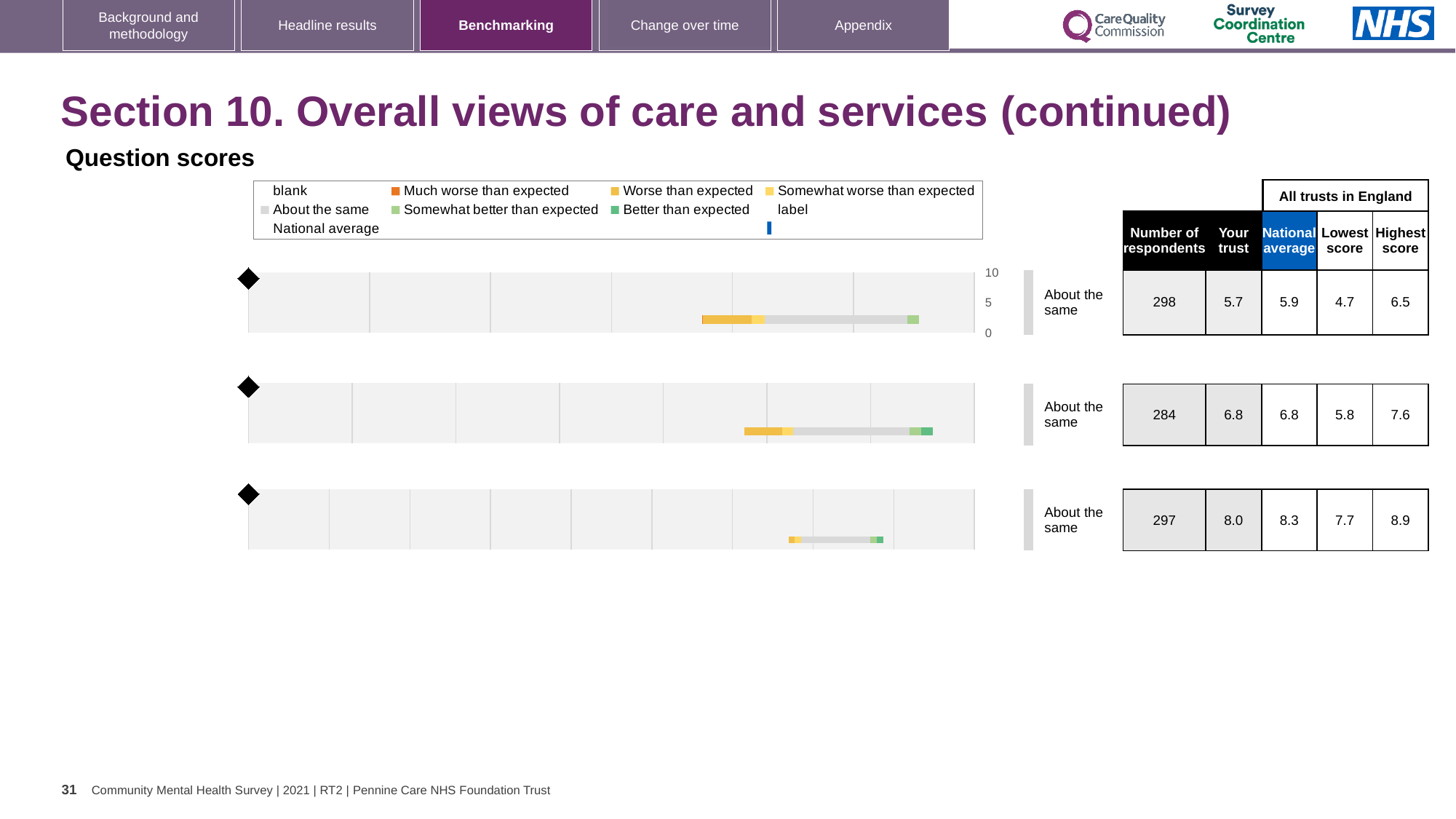
What is the national average for the middle chart? 6.8 For the middle chart, what is the difference between the highest score and the lowest score among all trusts in England? 1.8 For the bottom chart, what is the difference between the national average and the 'Your trust' score? 0.3 Which chart has the highest 'Your trust' score? The bottom chart (8.0) Which chart has the fewest respondents? The middle chart (284) What is the highest score among all trusts in England for the bottom chart? 8.9 What is the 'Your trust' score for the top chart? 5.7 How many respondents are shown for the top chart? 298 What benchmark category is shown for the top chart? About the same How many question charts are shown on the slide? 3 What is the lowest score among all trusts in England for the middle chart? 5.8 For the top chart, which is larger: the 'Your trust' score or the national average? National average